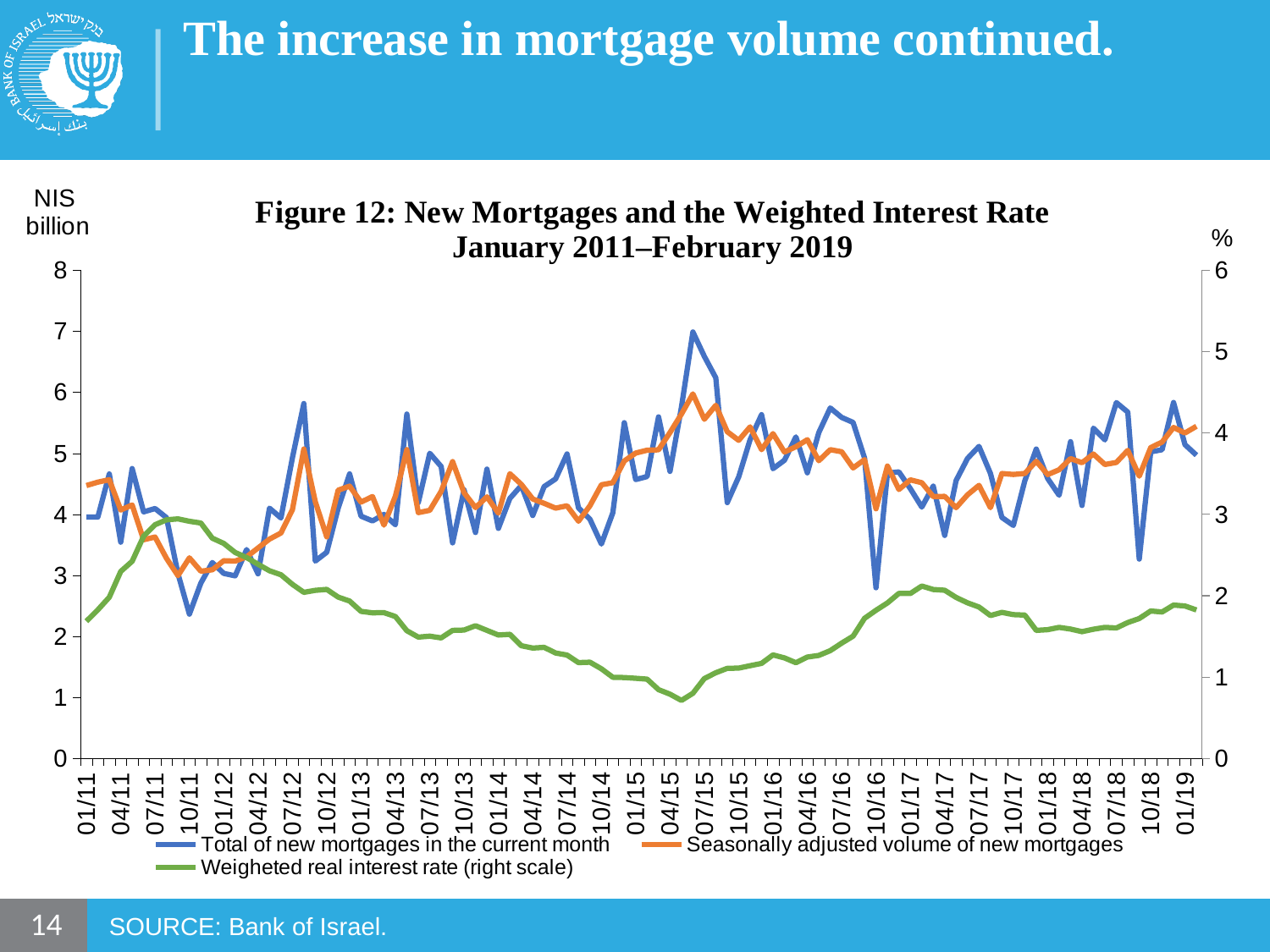
Is the highest value of the Total of new mortgages in the current month series greater or less than 6? greater What kind of chart is shown on the slide? line chart Is the value of Total of new mortgages in the current month at 10/11 greater or less than 3? less How many series does the legend list? 3 Which is larger: the Total of new mortgages in the current month at 07/15 or at 10/16? 07/15 Which series is plotted on the right scale? Weighted real interest rate What is the unit shown on the left axis? NIS billion Is the value of the Weighted real interest rate at 01/11 greater or less than 2? less In which year does the Weighted real interest rate series reach its lowest point? 2015 Does the Weighted real interest rate rise or fall between 10/11 and 04/15? fall In which year does the Total of new mortgages in the current month series reach its highest point? 2015